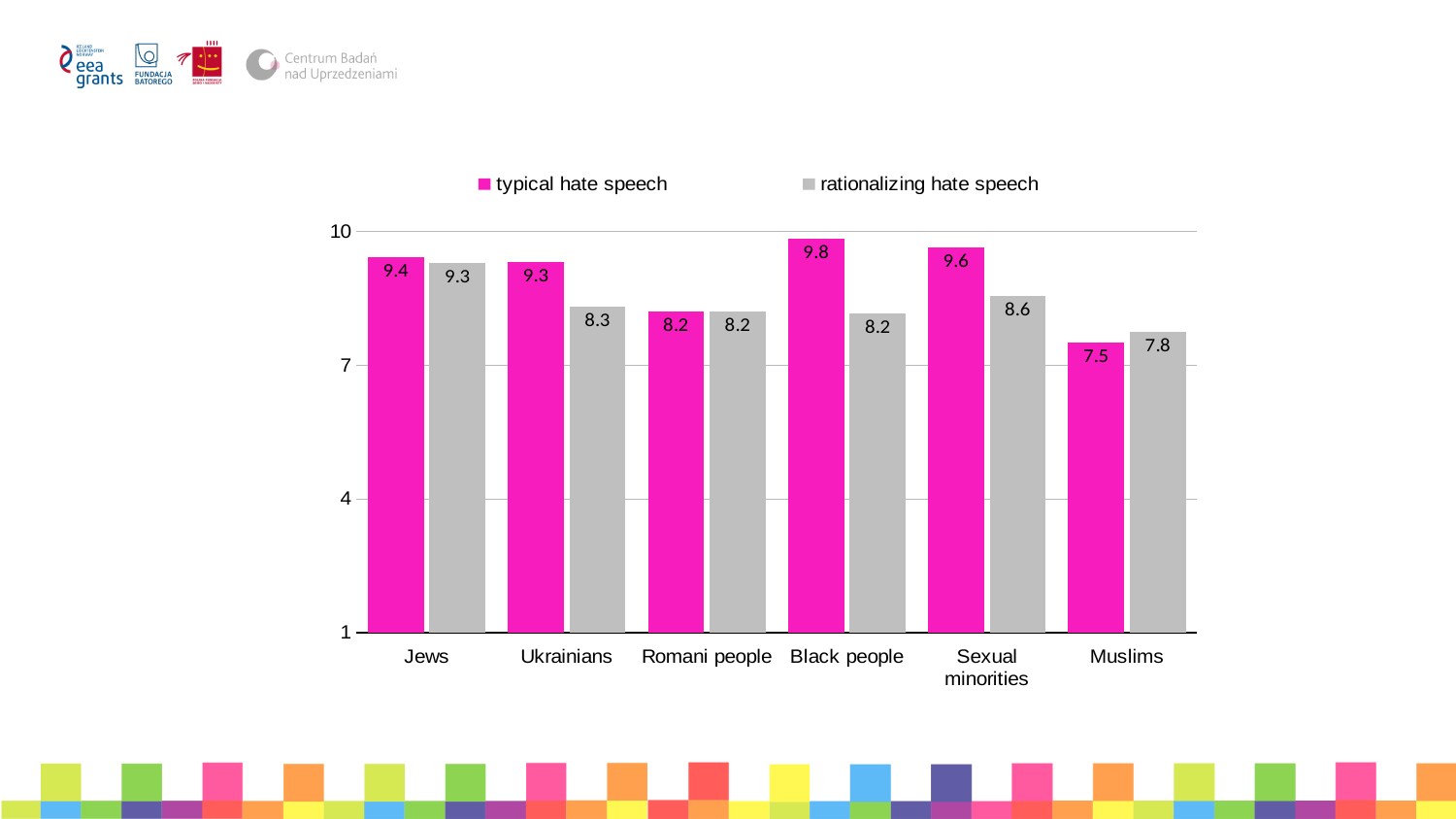
What is the value for typical hate speech for Muslims? 7.5 Is the value for rationalizing hate speech for Ukrainians greater or less than 7? greater What colour are the bars for typical hate speech? pink Which category has the highest value for typical hate speech? Black people How many series does the legend list? 2 Which category has the lowest value for rationalizing hate speech? Muslims How many categories are shown on the x axis? 6 Which is larger for Muslims: typical hate speech or rationalizing hate speech? rationalizing hate speech What is the value for typical hate speech for Jews? 9.4 What is the difference between the typical hate speech and rationalizing hate speech values for Black people? 1.6 What is the value for rationalizing hate speech for Sexual minorities? 8.6 What kind of chart is shown on the slide? bar chart